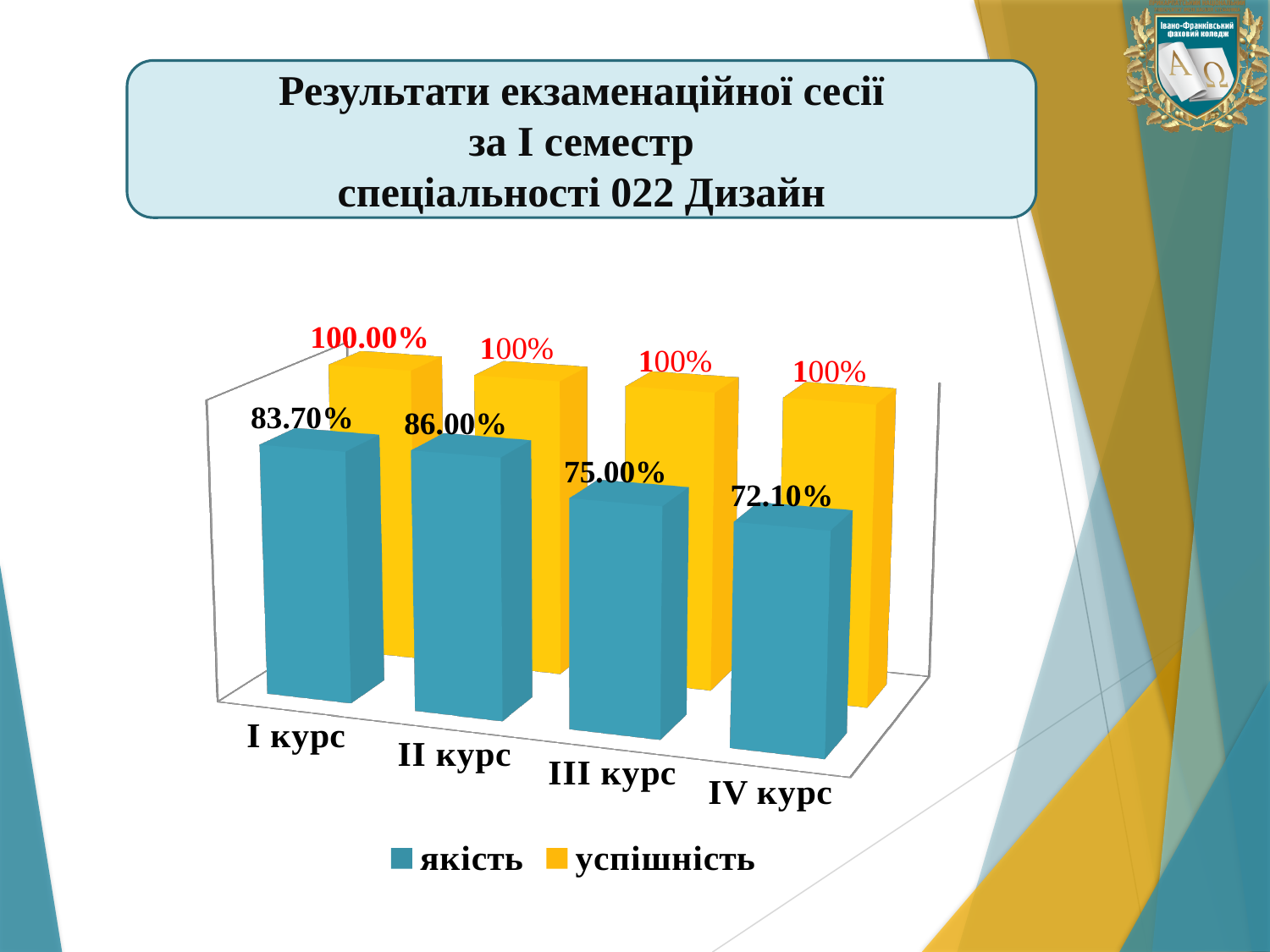
What is the difference between the якість values for II курс and IV курс? 13.90% What is the якість value for II курс? 86.00% Which course has the highest якість value? II курс Which course has the lowest якість value? IV курс Which is larger, the якість value for I курс or for III курс? I курс What is the якість value for IV курс? 72.10% How many courses (categories) are shown on the x axis? 4 What is the успішність value for I курс? 100.00% How many series does the legend list? 2 What is the якість value for III курс? 75.00% What is the якість value for I курс? 83.70% What kind of chart is shown on the slide? Bar chart